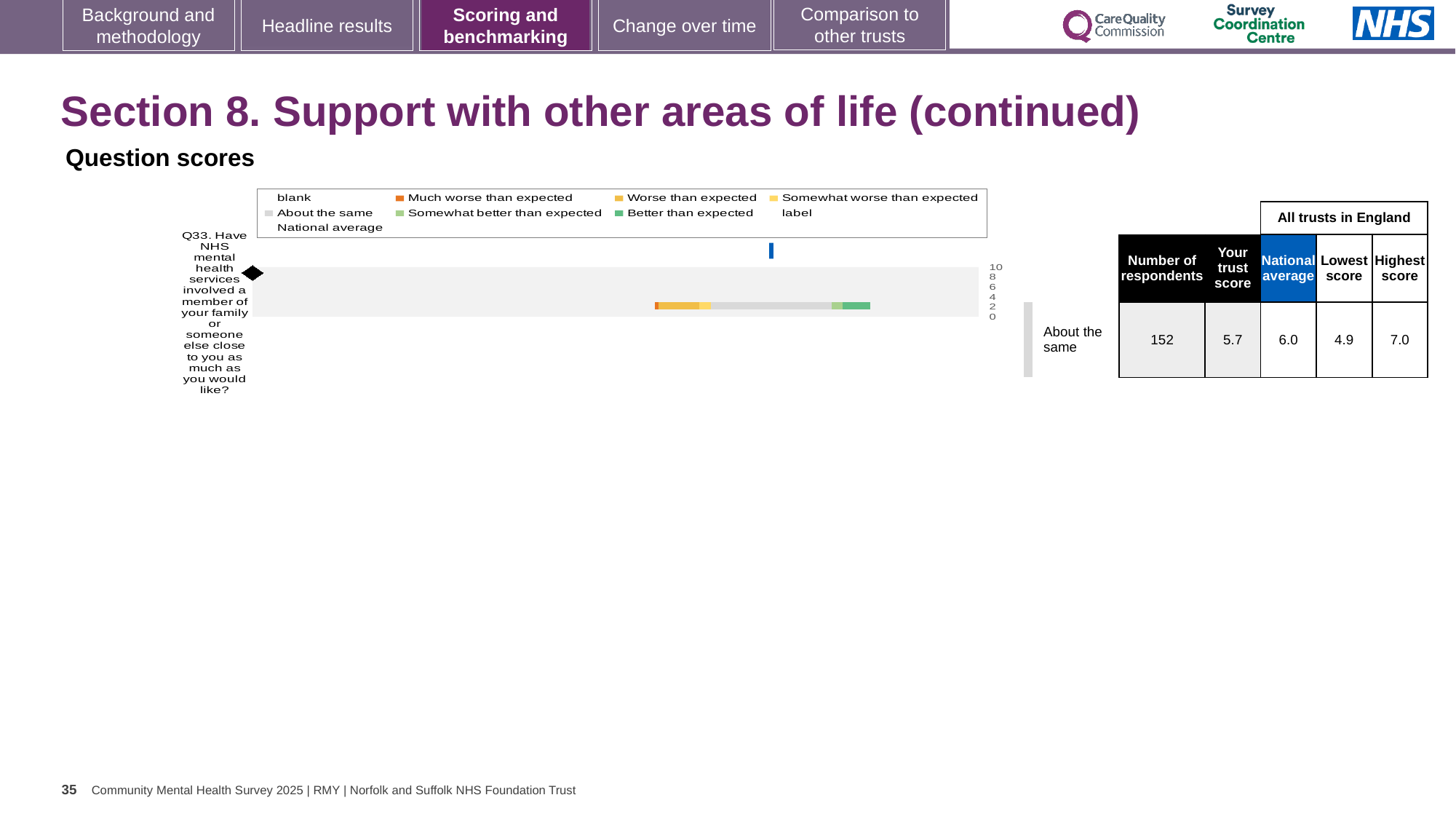
In the table beside the chart, what is 'Your trust score' for Q33? 5.7 In the table beside the chart, what is the Highest score among all trusts in England for Q33? 7.0 What colour does the legend use for 'Much worse than expected'? orange How many entries does the chart's legend list? 9 What benchmark category label is shown to the right of the Q33 bar? About the same In the table beside the chart, what is the Lowest score among all trusts in England for Q33? 4.9 What kind of chart is shown on the slide? bar chart In the table beside the chart, how many respondents answered Q33? 152 Which is larger for Q33: Your trust score or the National average? National average In the table beside the chart, what is the National average for Q33? 6.0 How many questions (categories) are plotted in the chart? 1 What is the difference between the National average and Your trust score for Q33? 0.3